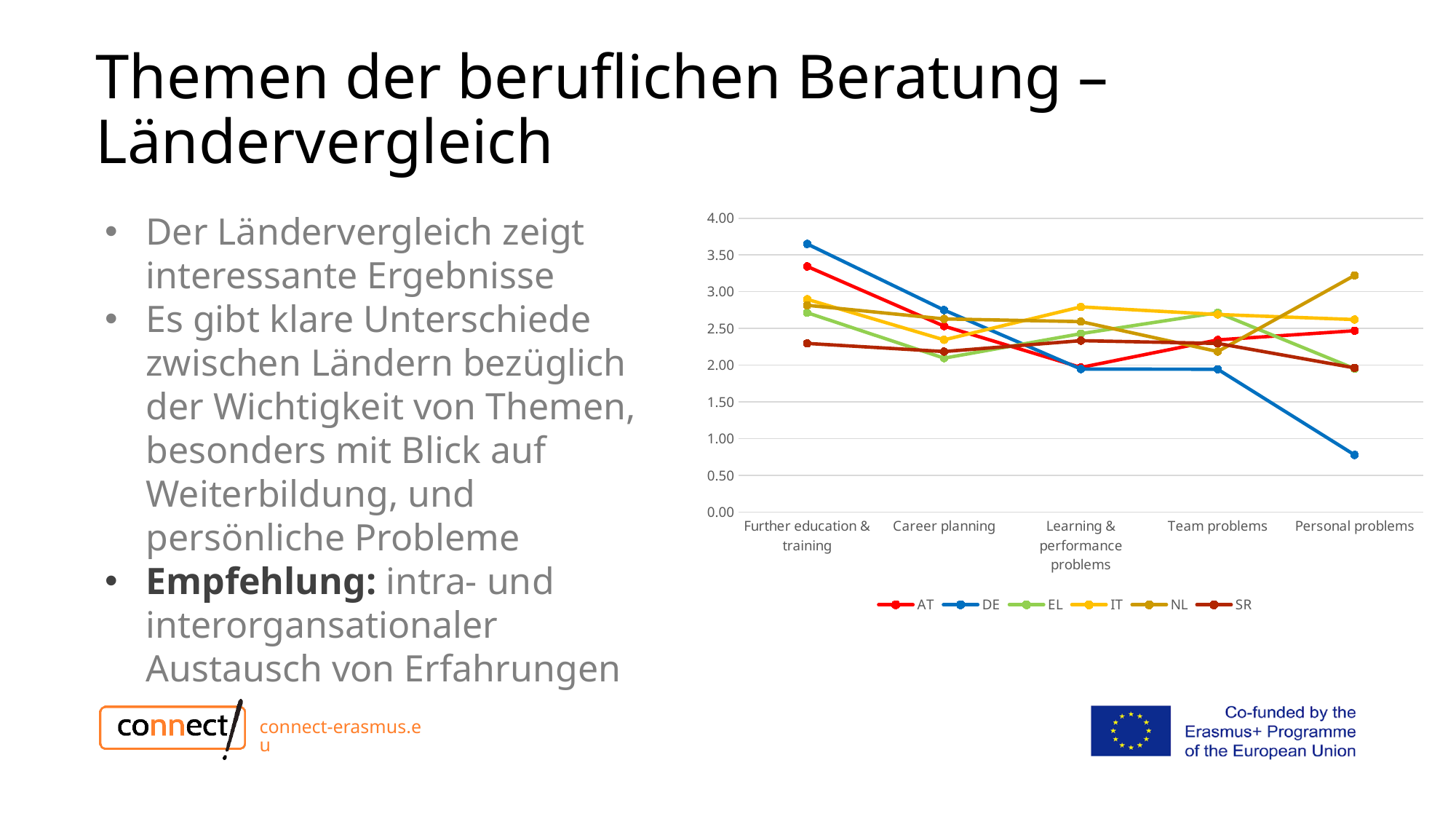
Which country has the highest value for Personal problems? NL What kind of chart is shown on the slide? line chart Which country has the lowest value for Personal problems? DE Which country has the highest value for Further education & training? DE What colour is the line for DE in the chart? blue Is the value for DE at Further education & training greater or less than 3.50? greater Is the value for DE at Personal problems greater or less than 1.00? less Does the DE line rise or fall from Further education & training to Personal problems? fall Is the value for AT at Further education & training greater or less than 3.00? greater How many series does the legend of the chart list? 6 How many categories are shown along the x axis of the chart? 5 At Personal problems, which is larger: the value for NL or the value for AT? NL